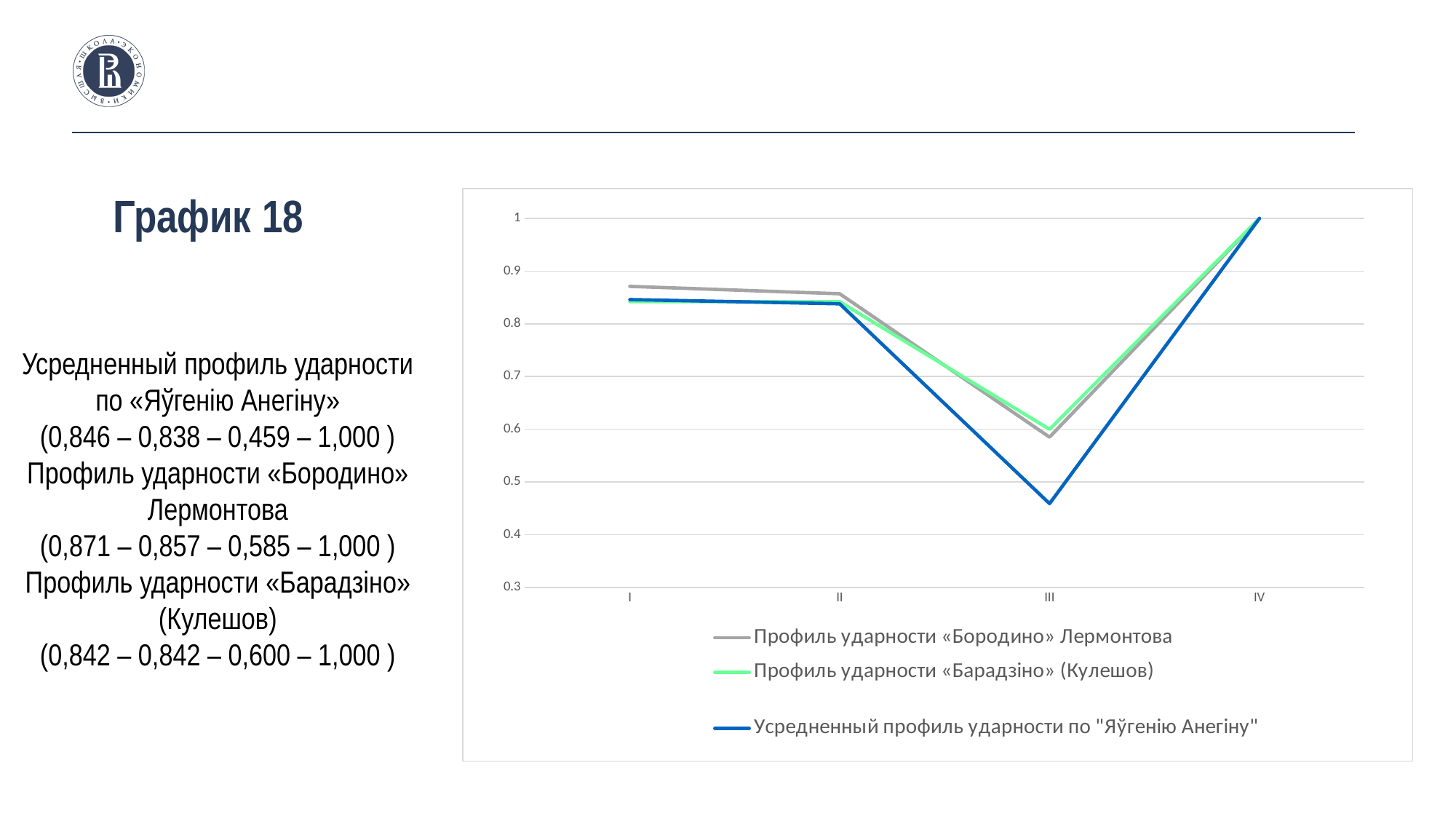
Is the value of the green series (Профиль ударности «Барадзіно» (Кулешов)) at position III greater or less than 0.7? less Is the value of the blue series (Усредненный профиль ударности по «Яўгенію Анегіну») at position III greater or less than 0.5? less At position III, which series has the lower value: the blue series or the green series? the blue series According to the text on the slide, what is the value of the Усредненный профиль ударности по «Яўгенію Анегіну» series at position III? 0,459 What kind of chart is shown on the slide? line chart How many series does the chart legend list? 3 At which x-axis position do all three series reach their highest value? IV Is the value of the grey series (Профиль ударности «Бородино» Лермонтова) at position I greater or less than 0.8? greater At which x-axis position do all three series reach their lowest value? III How many points are plotted along the x axis for each series? 4 Which colour is used for the Профиль ударности «Бородино» Лермонтова series? grey Do the values of the blue series rise or fall from position II to position III? fall